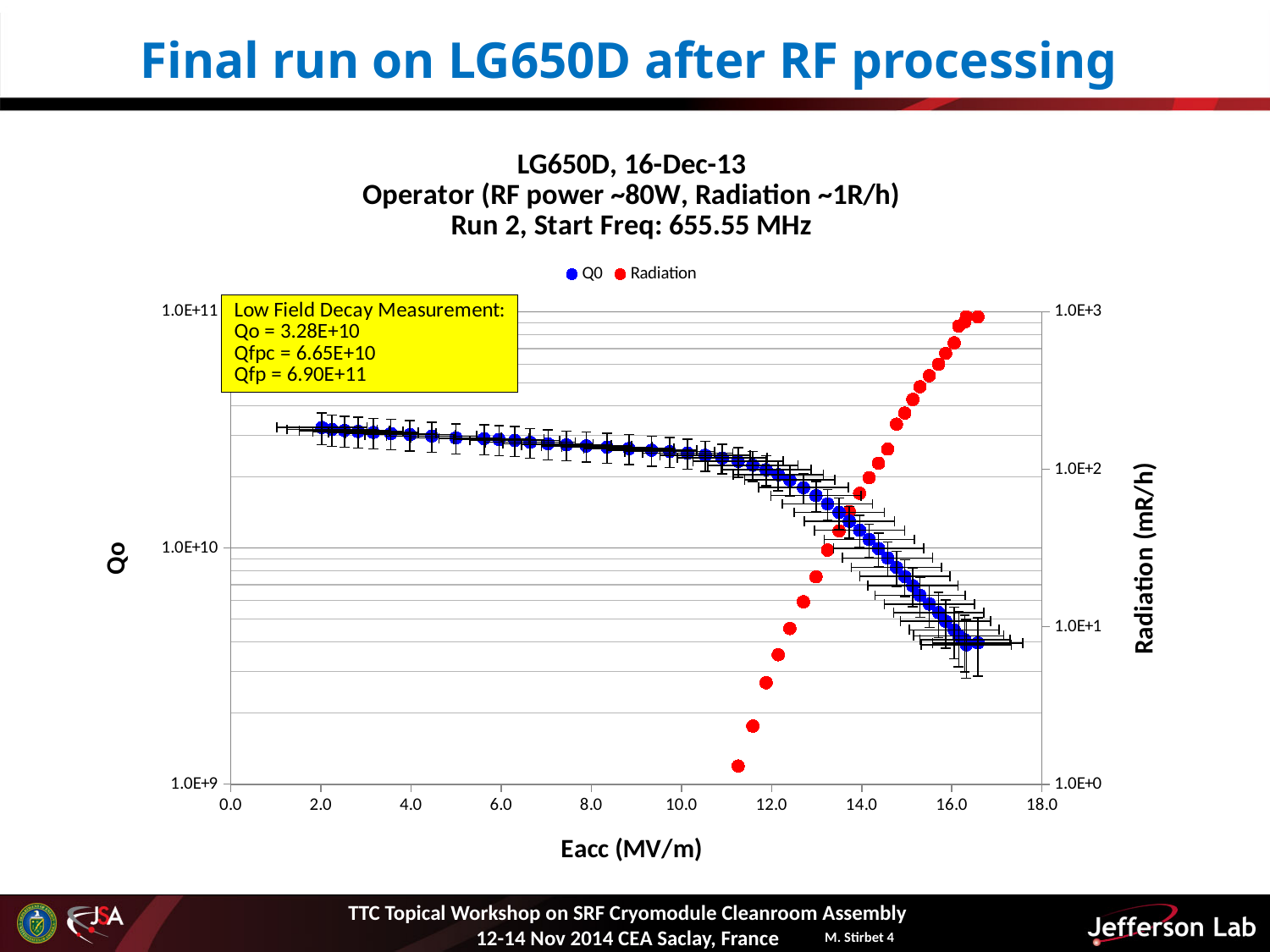
Is the Q0 value at Eacc = 2.0 MV/m greater or less than 1.0E+10? greater What are the two series named in the chart legend? Q0 and Radiation Is the Radiation value at Eacc = 11.5 MV/m greater or less than 1.0E+1 mR/h? less Does the Radiation series rise or fall as Eacc increases along the x axis? Rise Which is larger, the Radiation value at Eacc = 12.0 MV/m or the Radiation value at Eacc = 16.0 MV/m? Eacc = 16.0 MV/m Is the Radiation value at Eacc = 16.0 MV/m greater or less than 1.0E+2 mR/h? greater What kind of chart is shown on the slide? Scatter chart Does the Q0 series rise or fall as Eacc increases along the x axis? Fall How many series does the chart legend list? 2 What is the label of the x axis of the chart? Eacc (MV/m) Which is larger, the Q0 value at Eacc = 2.0 MV/m or the Q0 value at Eacc = 16.0 MV/m? Eacc = 2.0 MV/m